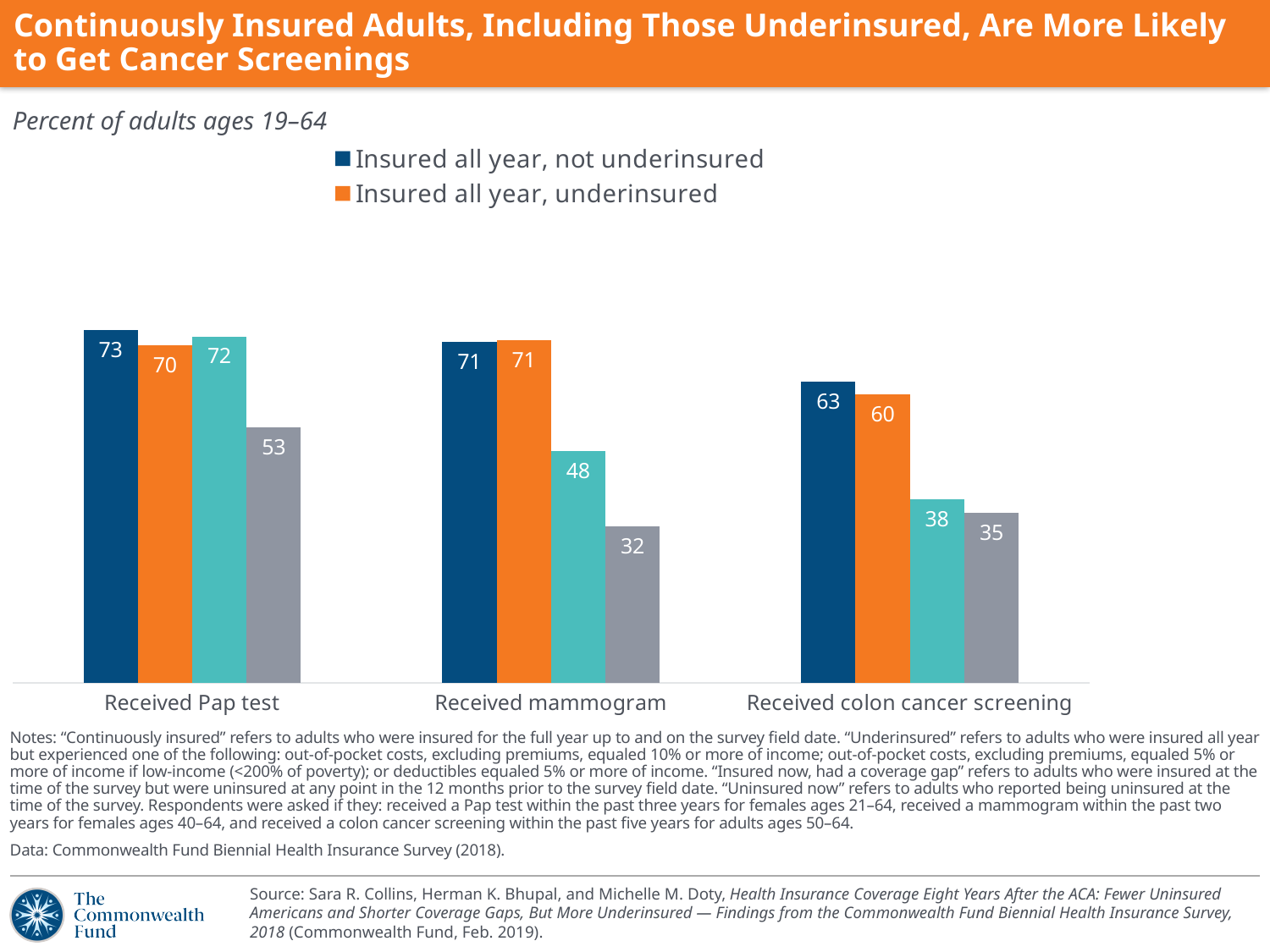
What is the value for 'Insured all year, not underinsured' in the 'Received colon cancer screening' category? 63 How many screening categories are shown on the x axis? 3 What kind of chart is shown on the slide? Bar chart How many series does the legend list? 2 In the 'Received colon cancer screening' category, what is the difference between 'Insured all year, not underinsured' and 'Insured all year, underinsured'? 3 What is the value for 'Insured all year, underinsured' in the 'Received mammogram' category? 71 In the 'Received Pap test' category, what is the difference between 'Insured all year, not underinsured' and 'Insured all year, underinsured'? 3 For the 'Insured all year, not underinsured' series, which category has the highest value? Received Pap test What is the value for 'Insured all year, underinsured' in the 'Received colon cancer screening' category? 60 For the 'Insured all year, underinsured' series, which category has the lowest value? Received colon cancer screening In the 'Received Pap test' category, which is larger: 'Insured all year, not underinsured' or 'Insured all year, underinsured'? Insured all year, not underinsured What is the value for 'Insured all year, not underinsured' in the 'Received Pap test' category? 73